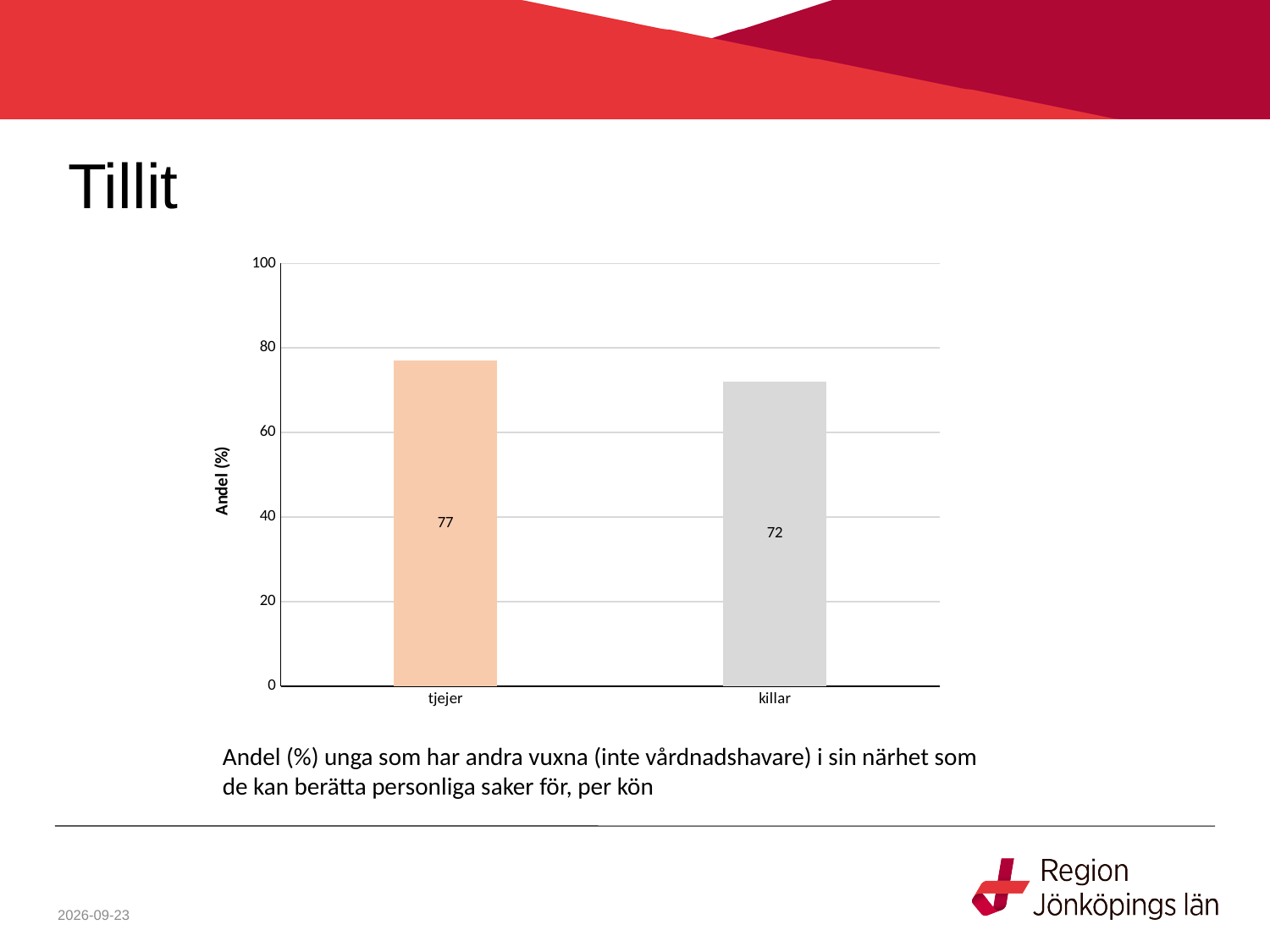
What is the label of the y axis? Andel (%) What is the value for tjejer? 77 What is the value for killar? 72 What is the difference between the values for tjejer and killar? 5 How many categories are shown on the x axis? 2 Is the value for killar greater or less than 80? less What kind of chart is shown on the slide? bar chart Which is larger, the value for tjejer or the value for killar? tjejer What is the maximum value shown on the y axis? 100 Is the value for tjejer greater or less than 60? greater Which category has the lowest value? killar Which category has the highest value? tjejer